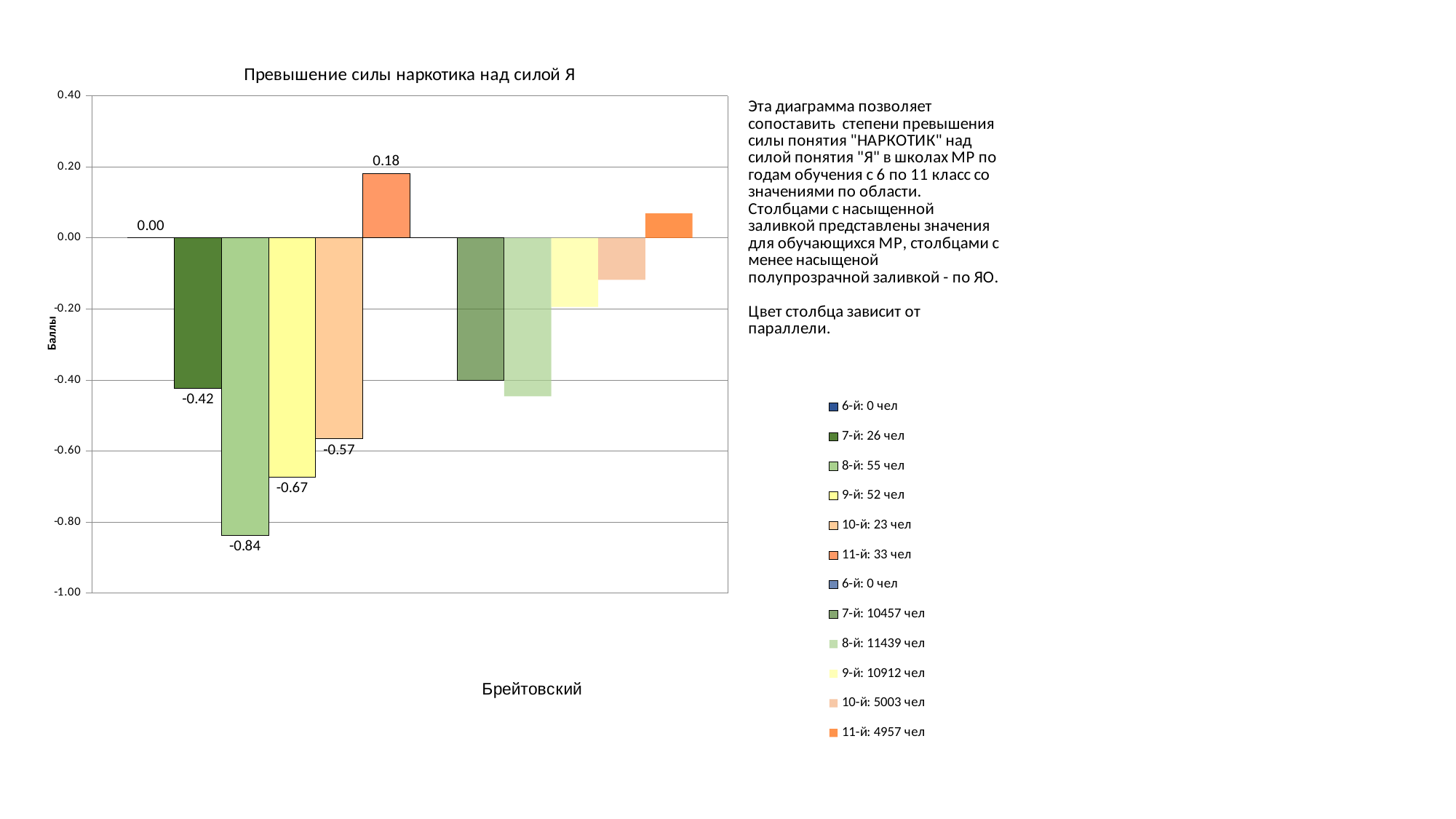
What is the value for the 9-й (52 чел) series for Брейтовский? -0.67 What is the value for the 7-й (26 чел) series for Брейтовский? -0.42 How many series does the legend list? 12 What is the value for the 11-й (33 чел) series for Брейтовский? 0.18 Which of the labelled MR series has the lowest value? 8-й: 55 чел Which of the labelled MR series has the highest value? 11-й: 33 чел What is the value for the 10-й (23 чел) series for Брейтовский? -0.57 What is the title of the chart? Превышение силы наркотика над силой Я Is the value for the 9-й (10912 чел) series greater or less than -0.40? greater What is the difference between the 8-й (55 чел) value and the 9-й (52 чел) value? 0.17 What type of chart is shown on the slide? bar chart What is the value for the 8-й (55 чел) series for Брейтовский? -0.84